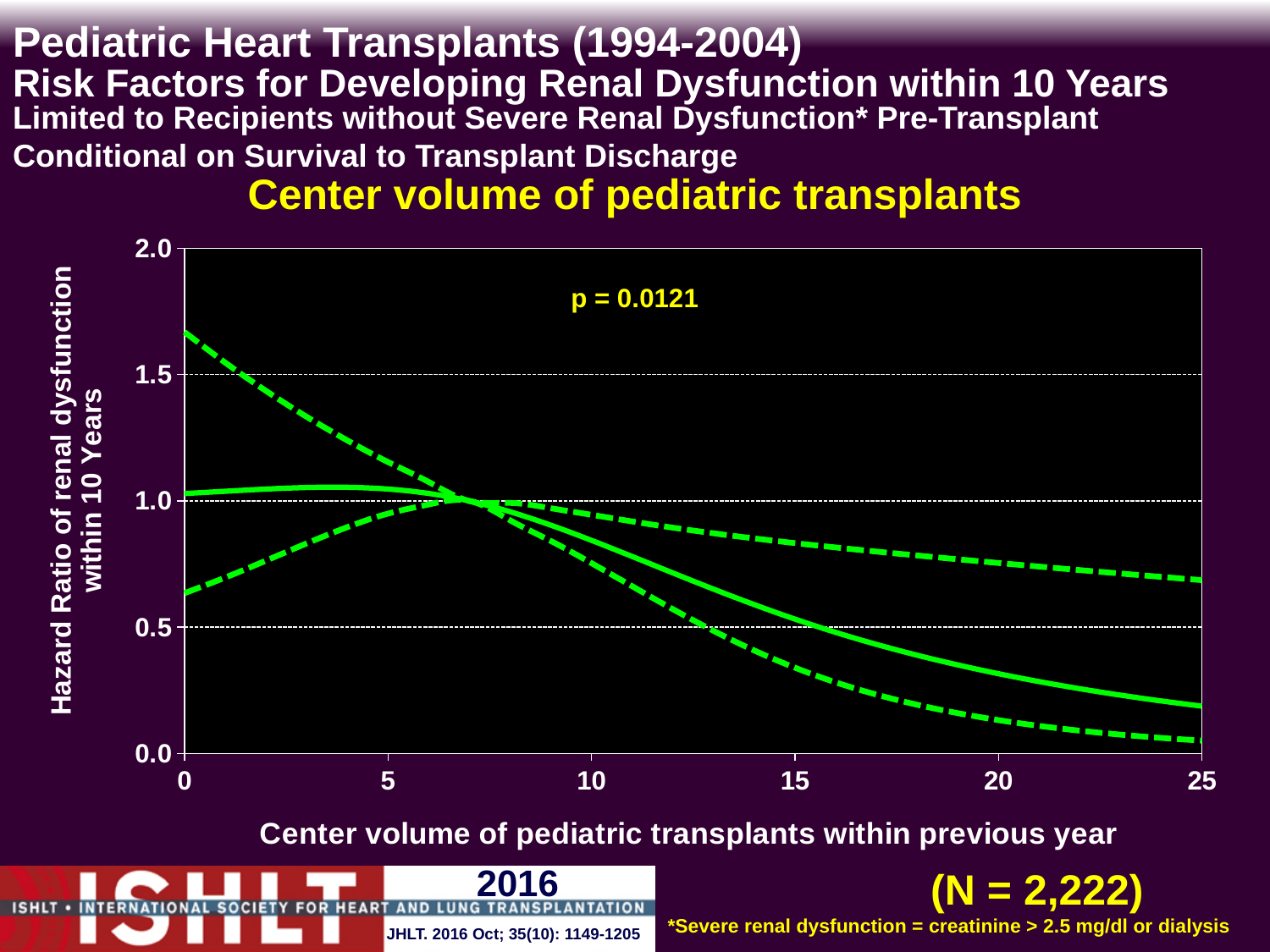
Does the solid line (hazard ratio) rise or fall as center volume increases from 10 to 25? fall Is the value of the solid hazard ratio line at a center volume of 5 greater or less than 0.5? greater What is the title of the chart? Center volume of pediatric transplants What is the label of the x axis? Center volume of pediatric transplants within previous year Is the value of the solid hazard ratio line at a center volume of 25 greater or less than 0.5? less What is the maximum value shown on the y axis? 2.0 Is the value of the lower dashed line at a center volume of 20 greater or less than 0.5? less What kind of chart is shown on the slide? line chart How many lines are plotted on the chart? 3